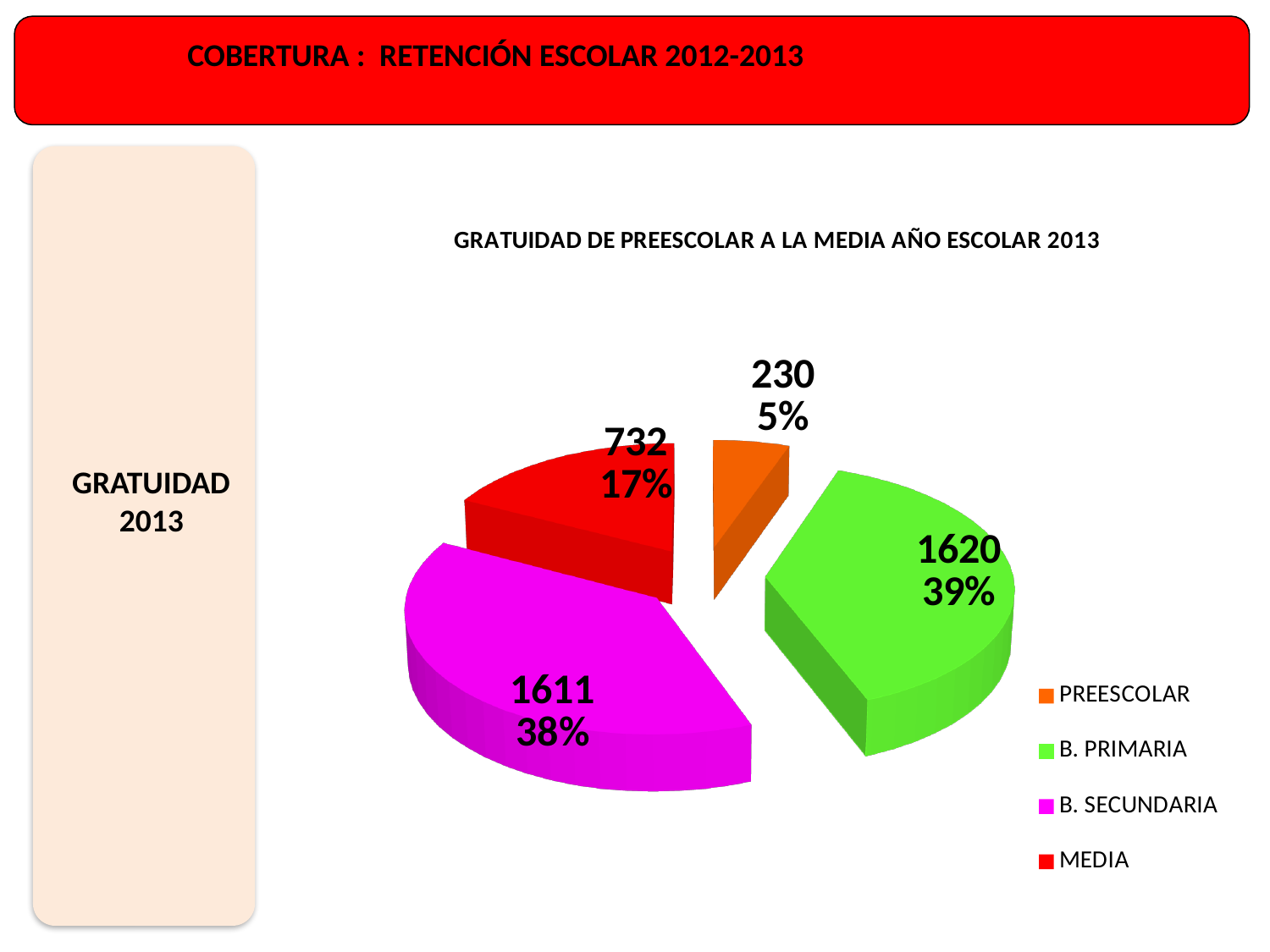
What share of the pie does B. PRIMARIA represent? 39% What type of chart is shown on the slide? Pie chart What is the value for B. SECUNDARIA? 1611 What is the difference between the values for B. PRIMARIA and PREESCOLAR? 1390 What is the title of the chart? GRATUIDAD DE PREESCOLAR A LA MEDIA AÑO ESCOLAR 2013 What is the value for MEDIA? 732 What share of the pie does MEDIA represent? 17% How many categories does the pie chart have? 4 What is the value for PREESCOLAR? 230 Which category has the smallest slice? PREESCOLAR Which is larger, the value for MEDIA or the value for PREESCOLAR? MEDIA Which category has the largest slice? B. PRIMARIA